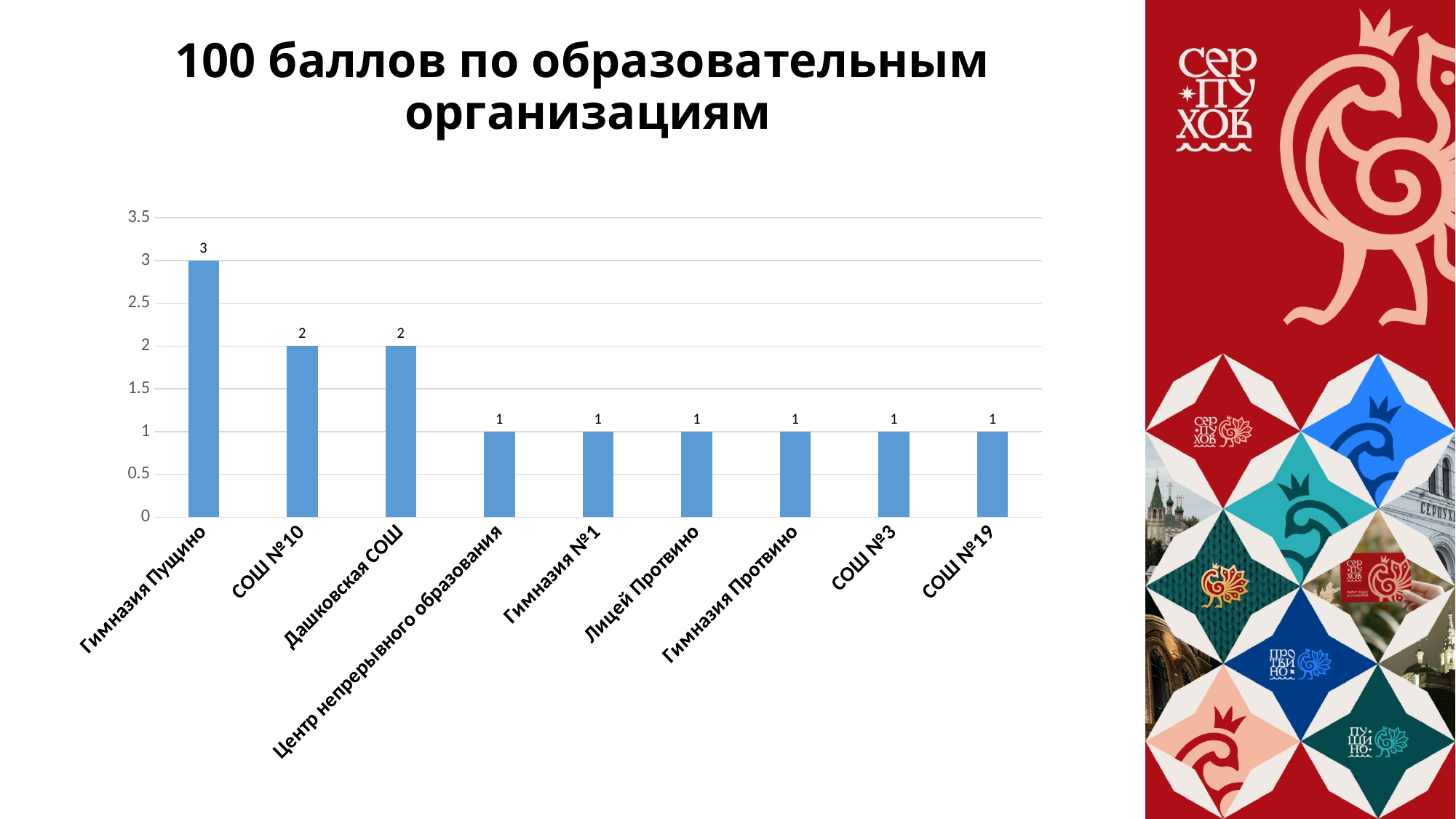
What is the difference between the values for Гимназия Пущино and Дашковская СОШ? 1 What is the title of the slide? 100 баллов по образовательным организациям How many categories are shown on the x axis? 9 What is the value for СОШ №10? 2 Which category has the highest value? Гимназия Пущино Do the values rise or fall from left to right along the x axis? fall What is the value for Лицей Протвино? 1 What is the highest value shown on the vertical axis? 3.5 Is the value for Гимназия Пущино greater or less than 2.5? greater What is the value for Гимназия Пущино? 3 What kind of chart is shown on the slide? bar chart Which is larger, the value for СОШ №10 or the value for СОШ №3? СОШ №10